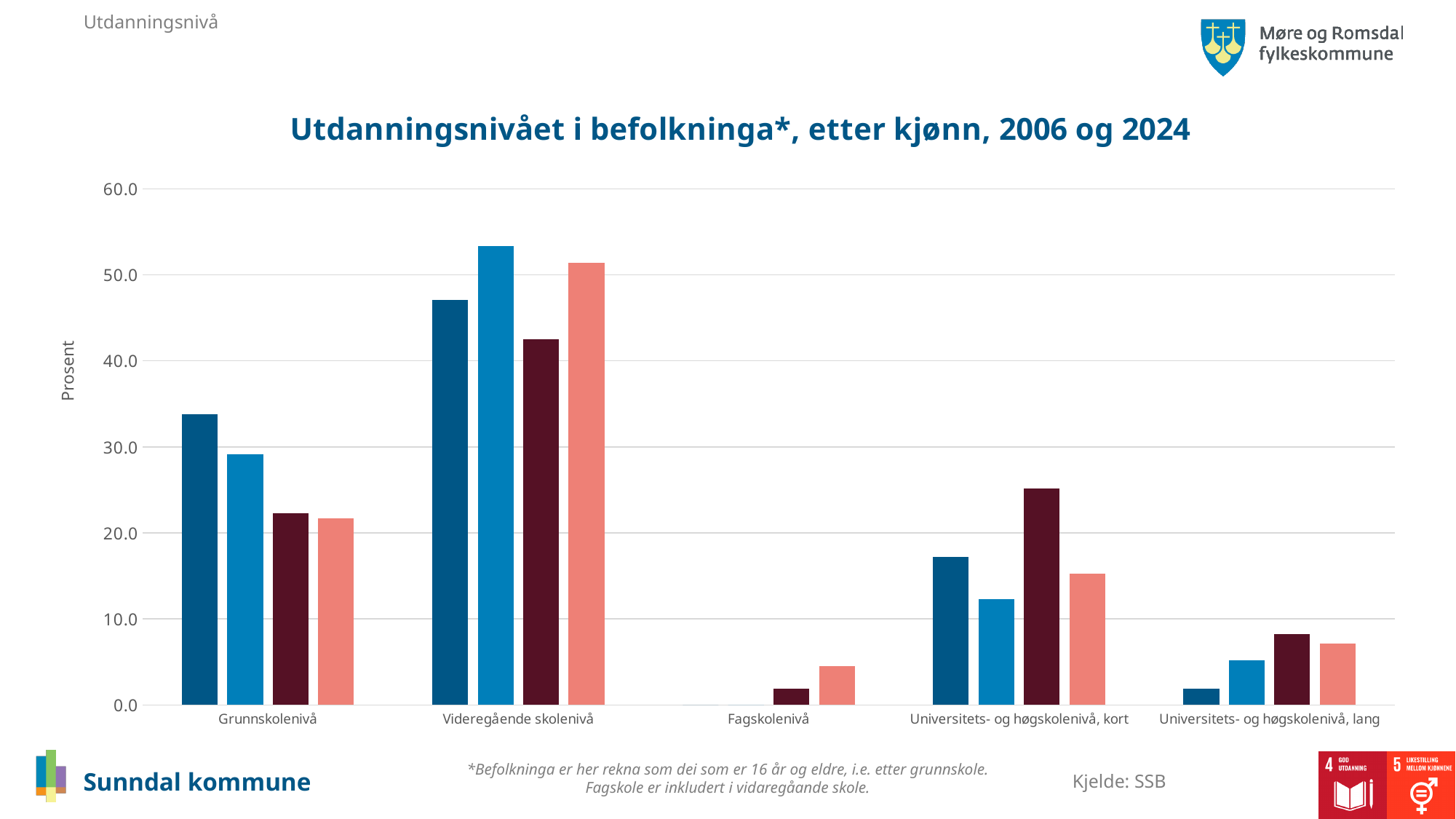
Is the value of the dark maroon (third) bar for Universitets- og høgskolenivå, kort greater or less than 20.0? greater How many education-level categories are shown on the x axis? 5 Is the value of the salmon (last) bar for Fagskolenivå greater or less than 10.0? less Which category has the tallest bars in the chart? Videregående skolenivå Which category has the lowest values overall in the chart? Fagskolenivå What is the label on the y axis of the chart? Prosent What kind of chart is shown on the slide? bar chart What is the title of the chart? Utdanningsnivået i befolkninga*, etter kjønn, 2006 og 2024 Is the value of the light blue (second) bar for Videregående skolenivå greater or less than 50.0? greater How many bars are plotted for the Grunnskolenivå category? 4 For Grunnskolenivå, which is larger: the dark blue (first) bar or the light blue (second) bar? the dark blue (first) bar